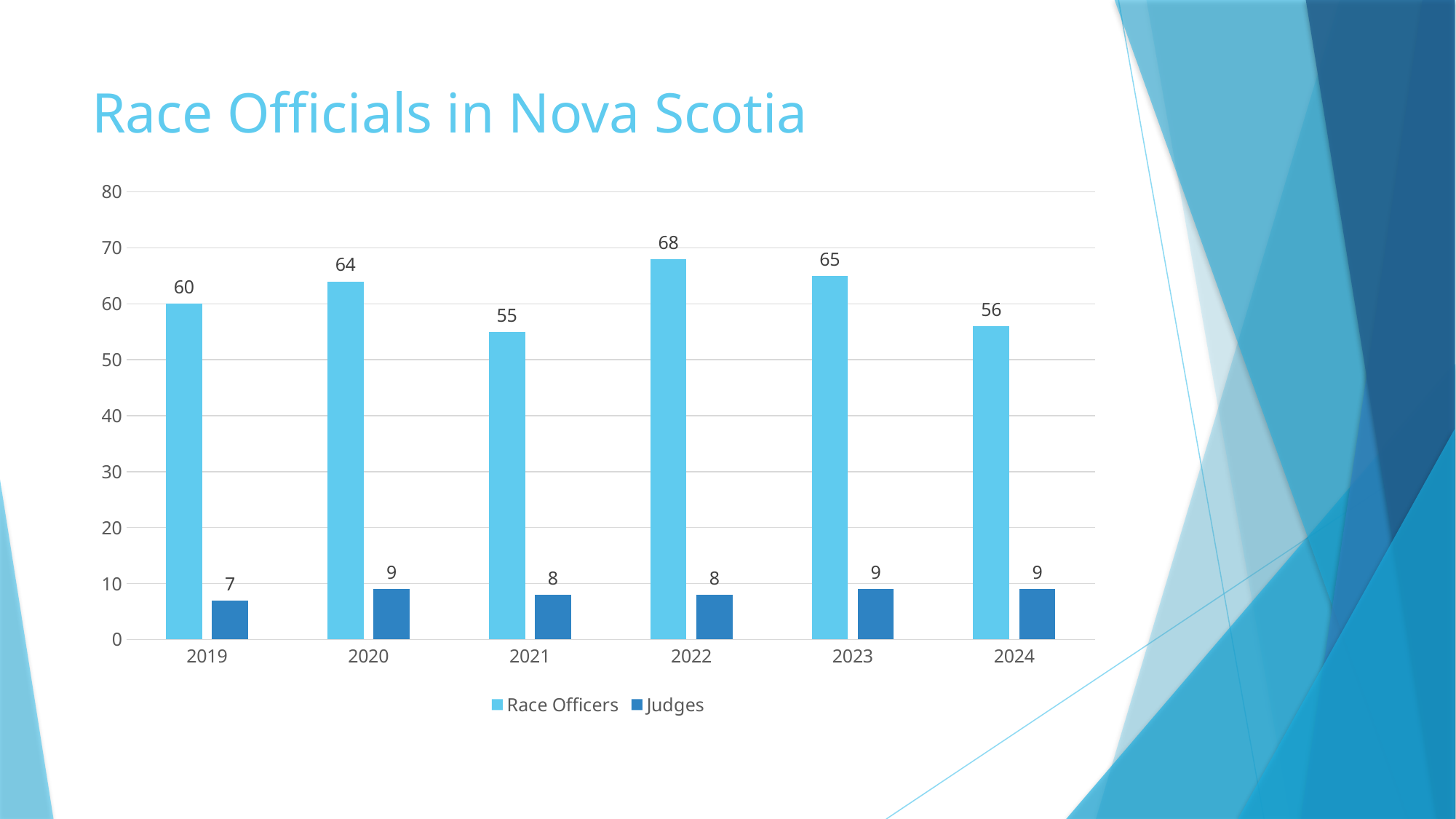
How many years are shown on the x axis? 6 What kind of chart is shown on the slide? bar chart How many Judges were there in 2019? 7 Which year had more Race Officers, 2020 or 2023? 2023 What is the title of the chart? Race Officials in Nova Scotia How many Race Officers were there in 2022? 68 Did the number of Race Officers rise or fall from 2023 to 2024? fall How many series does the legend list? 2 In which year was the number of Race Officers lowest? 2021 What is the difference between the number of Race Officers in 2022 and in 2024? 12 In which year was the number of Race Officers highest? 2022 Is the number of Race Officers in 2021 greater or less than 60? less